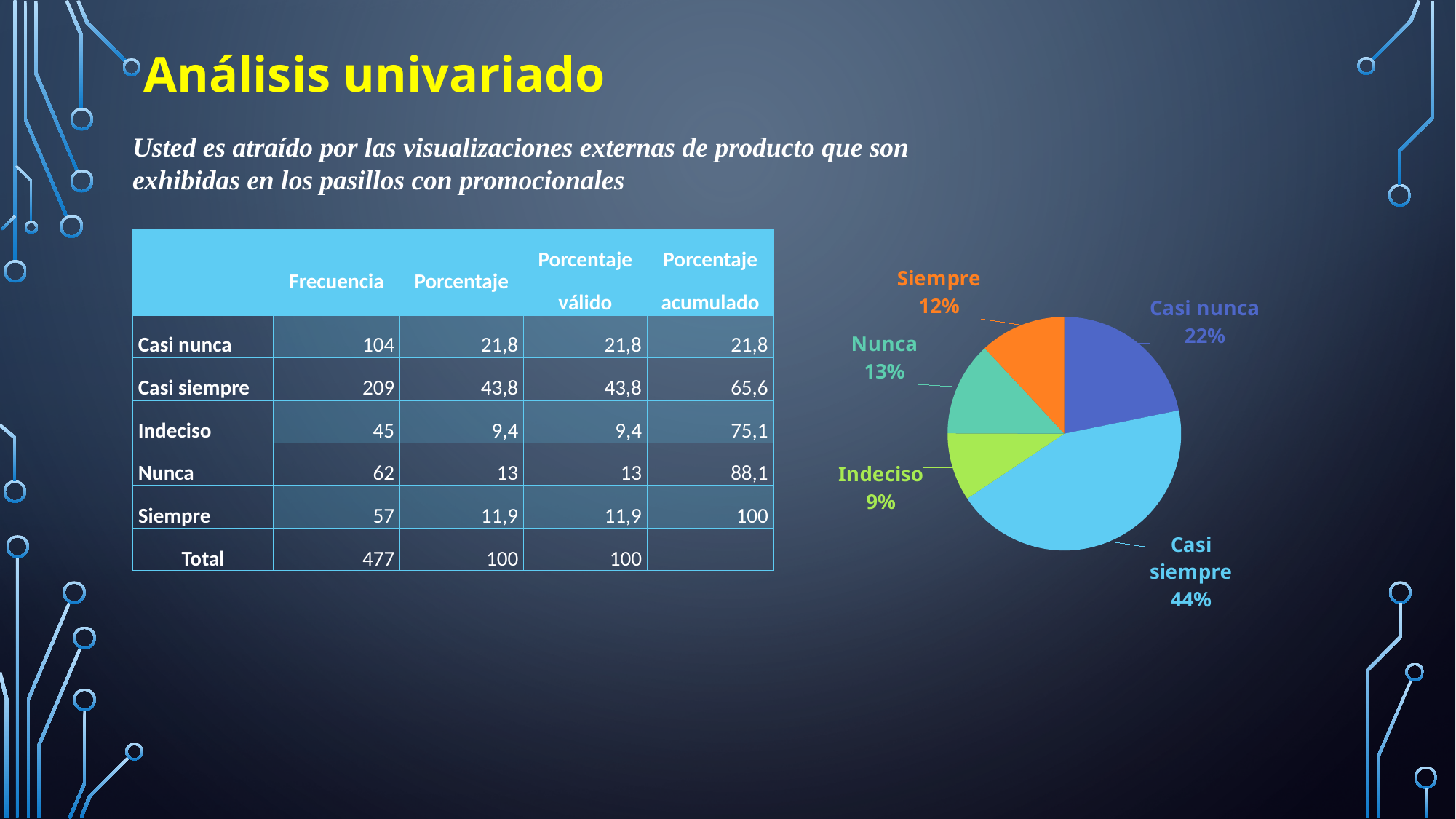
Which category has the smallest slice of the pie? Indeciso What share of the pie does Siempre represent? 12% What is the difference in percentage points between the Casi siempre and Casi nunca slices? 22% How many slices does the pie chart have? 5 What kind of chart is shown on the slide? pie chart What share of the pie does Nunca represent? 13% Which category has the largest slice of the pie? Casi siempre What share of the pie does Casi siempre represent? 44% What colour is the Siempre slice of the pie? orange Which slice is larger, Nunca or Siempre? Nunca